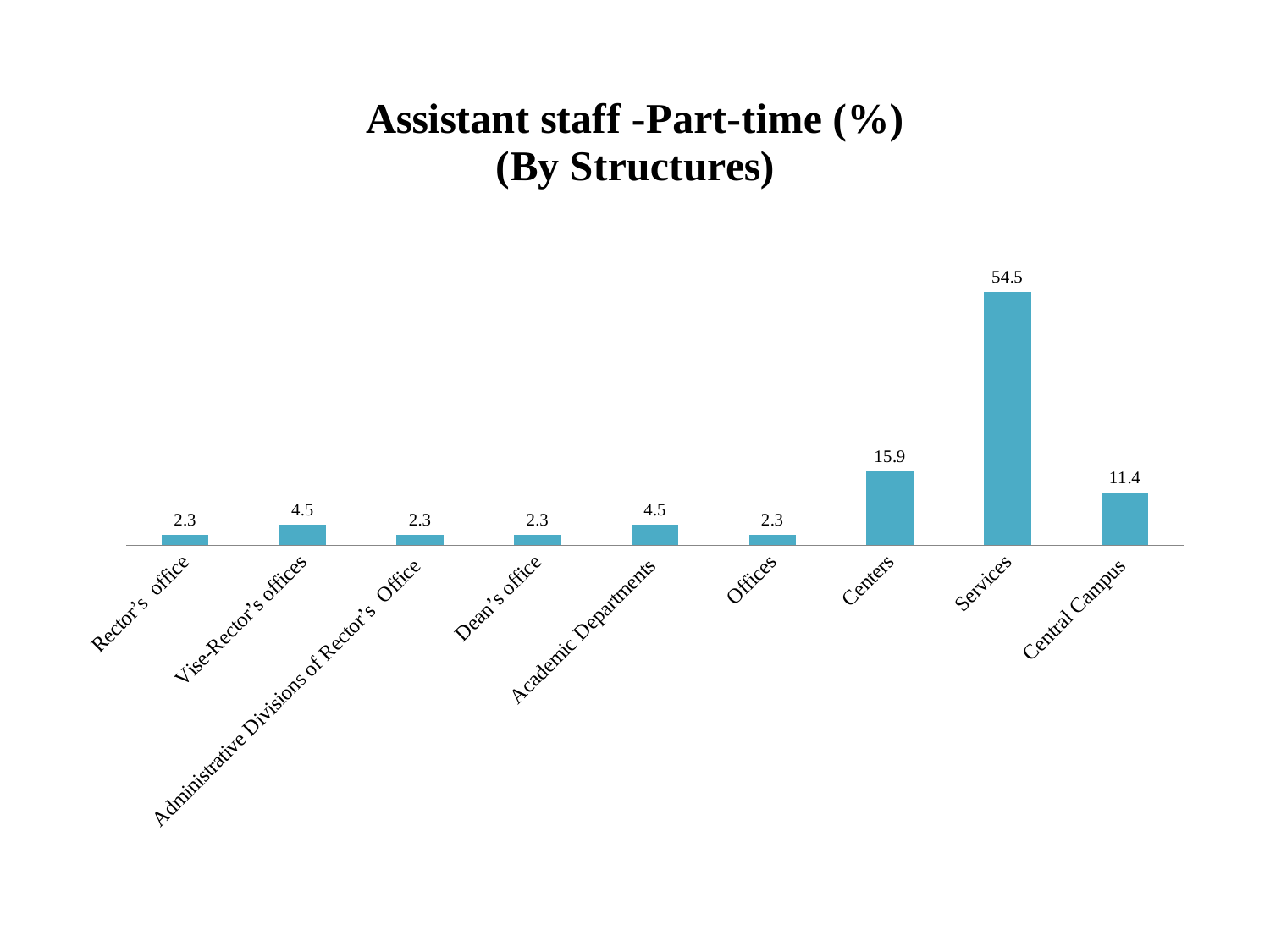
What is the difference between the values for Services and Centers? 38.6 What is the value for Centers? 15.9 Which is larger, the value for Vise-Rector's offices or the value for Offices? Vise-Rector's offices Which category has the highest value? Services What is the value for Dean's office? 2.3 What is the value for Academic Departments? 4.5 How many categories are shown on the x axis? 9 What is the difference between the values for Centers and Central Campus? 4.5 What is the value for Services? 54.5 What is the value for Central Campus? 11.4 What is the title of the chart? Assistant staff -Part-time (%) (By Structures) What kind of chart is shown on the slide? Bar chart